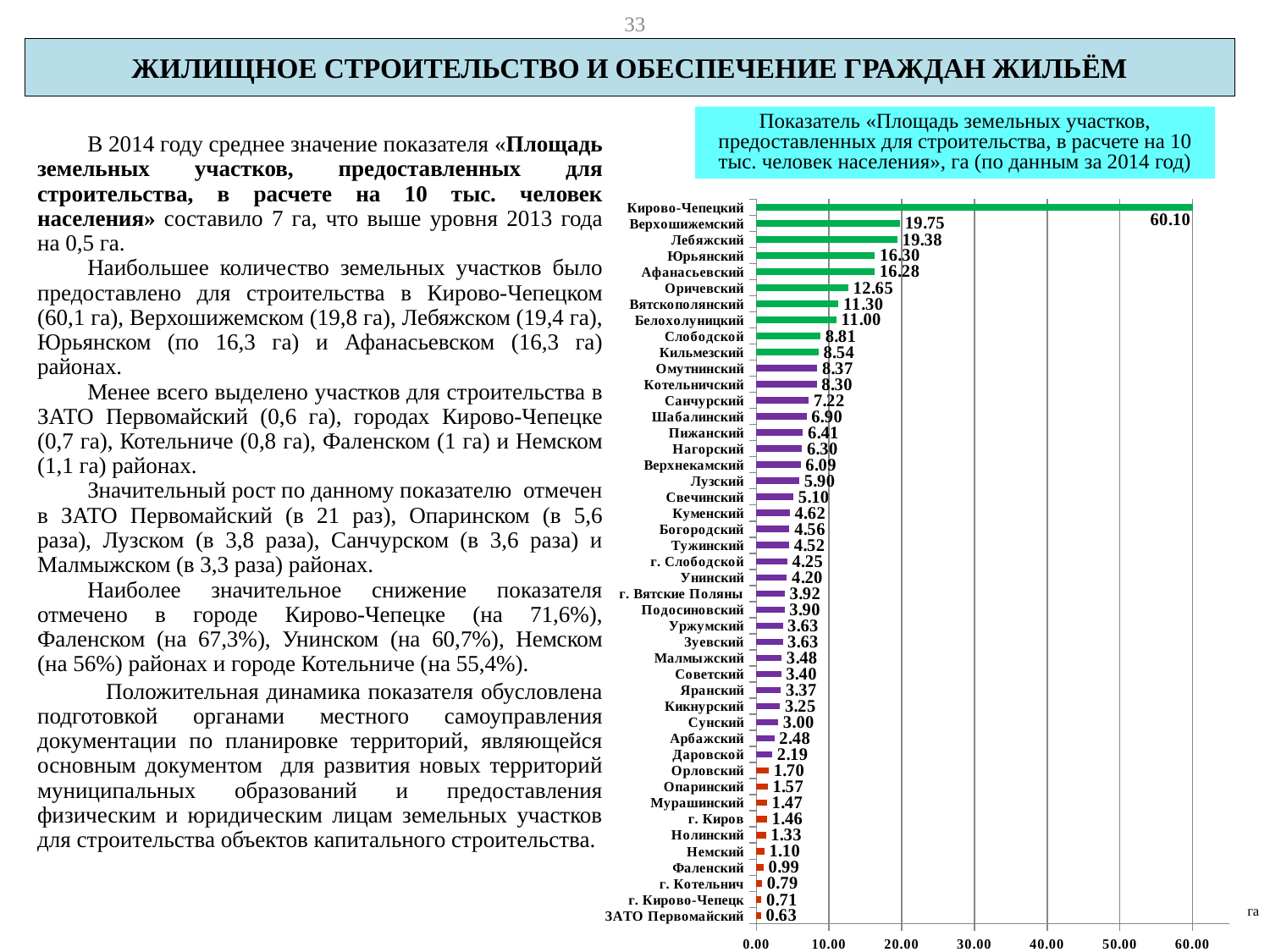
What is the value for Лузский? 5.90 Which category has the lowest value? ЗАТО Первомайский Which category has the highest value? Кирово-Чепецкий What is the difference between the values for Верхошижемский and Лебяжский? 0.37 What unit is shown at the end of the horizontal axis? га Which is larger, the value for Оричевский or the value for Белохолуницкий? Оричевский What is the value for Кирово-Чепецкий? 60.10 How many categories are shown on the chart? 45 What type of chart is shown on the slide? bar chart Is the value for Юрьянский greater or less than 10.00? greater What is the value for Верхошижемский? 19.75 What is the value for г. Киров? 1.46